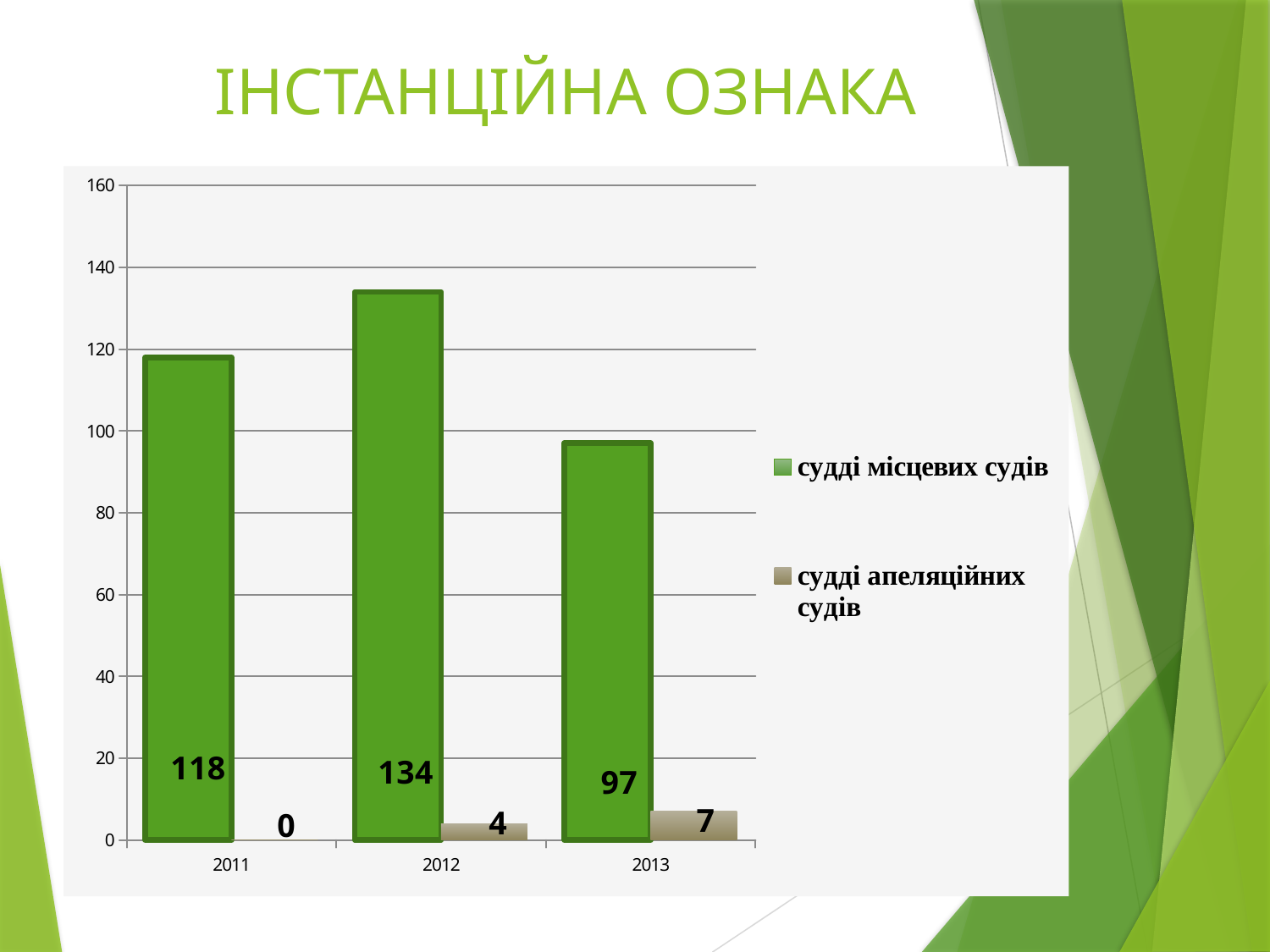
In which year is the value for судді місцевих судів highest? 2012 In which year is the value for судді місцевих судів lowest? 2013 What kind of chart is shown on the slide? bar chart Do the values for судді апеляційних судів rise or fall from 2011 to 2013? rise Which is larger: судді місцевих судів in 2011 or in 2013? 2011 Is the value for судді місцевих судів in 2011 greater or less than 100? greater What is the value for судді апеляційних судів in 2013? 7 What is the difference between the values for судді місцевих судів in 2012 and 2013? 37 How many years are shown on the x axis? 3 What is the value for судді місцевих судів in 2012? 134 How many series does the legend list? 2 What is the value for судді апеляційних судів in 2011? 0